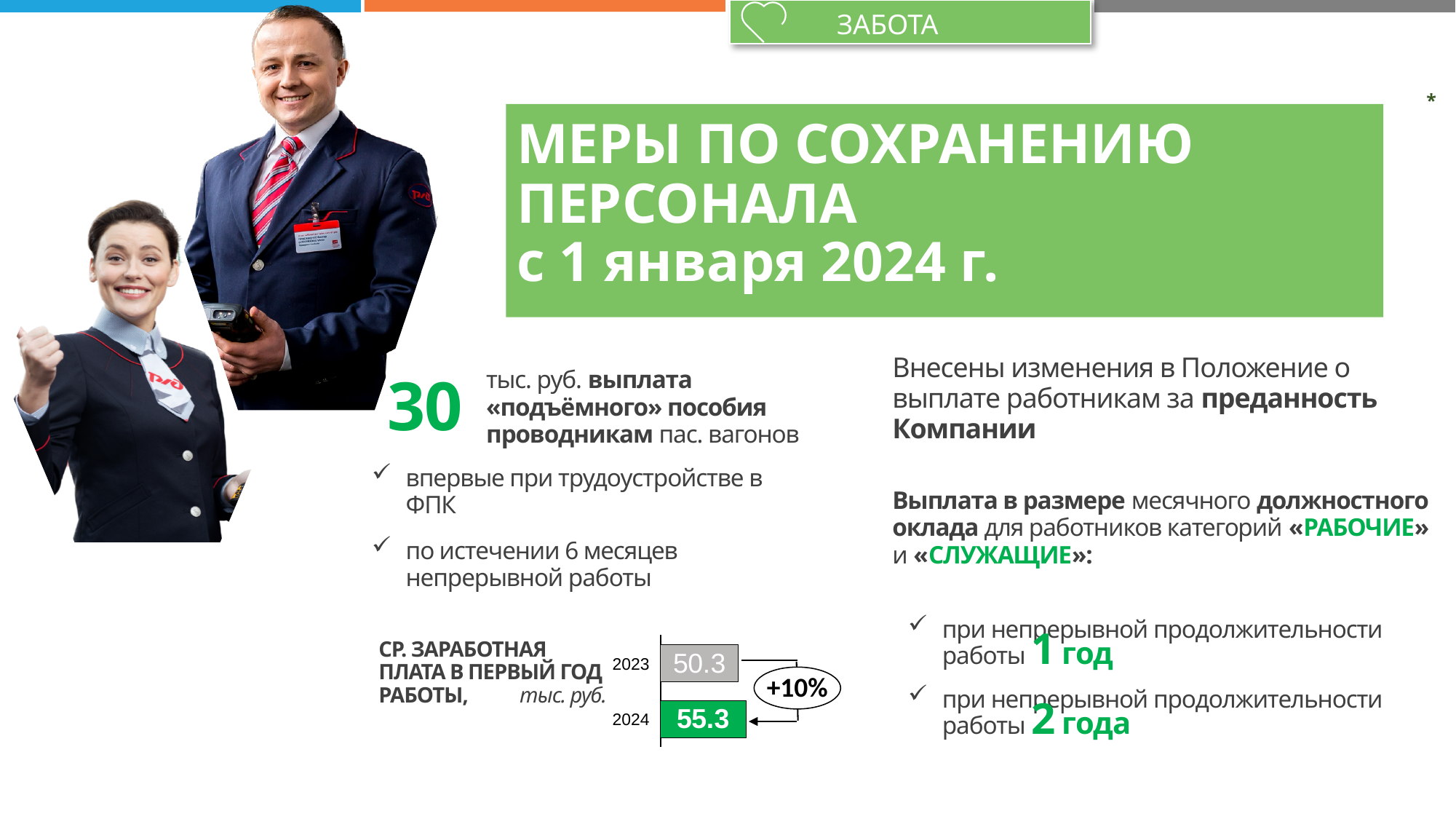
Which year has the lower value in the salary chart? 2023 In what units are the values of the salary chart expressed? тыс. руб. Which year has the higher value in the salary chart, 2023 or 2024? 2024 Does the average first-year salary rise or fall from 2023 to 2024? rise What percentage change is annotated between the 2023 and 2024 bars in the salary chart? +10% What is the average salary in the first year of work for 2023 according to the chart? 50.3 What type of chart is used to show the average salary in the first year of work? bar chart How many years (categories) are shown in the salary chart? 2 Is the value for 2024 larger or smaller than the value for 2023 in the salary chart? larger What is the average salary in the first year of work for 2024 according to the chart? 55.3 By how much does the 2024 value exceed the 2023 value in the salary chart? 5.0